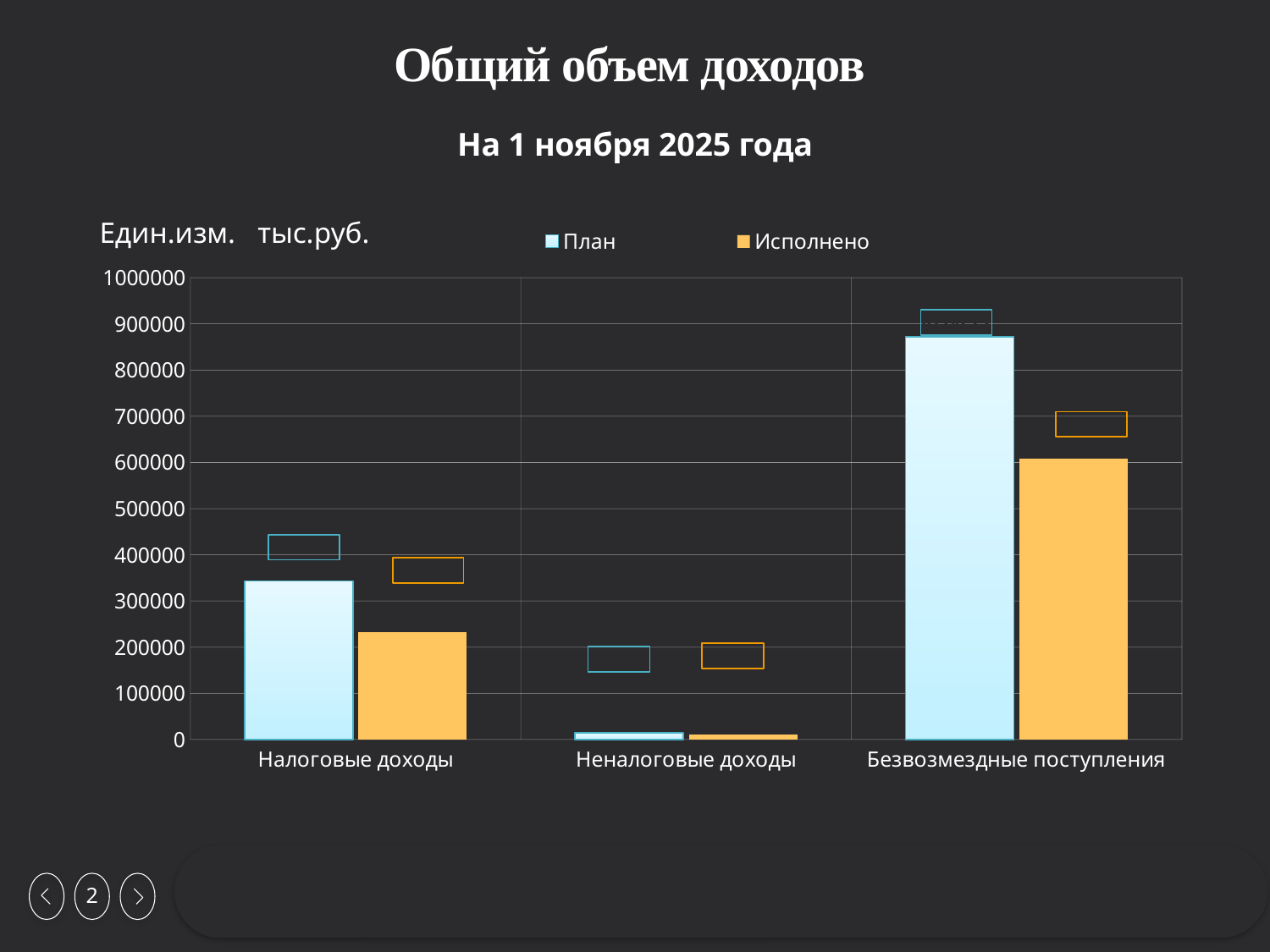
Is the План value for Безвозмездные поступления greater or less than 800000? greater Is the Исполнено value for Безвозмездные поступления greater or less than 700000? less For Безвозмездные поступления, which is larger: План or Исполнено? План Which category has the highest План value? Безвозмездные поступления Which category has the lowest Исполнено value? Неналоговые доходы Is the Исполнено value for Налоговые доходы greater or less than 300000? less How many categories are shown on the x axis? 3 What unit of measurement is stated on the slide for the chart values? тыс.руб. What kind of chart is shown on the slide? bar chart How many series does the legend list? 2